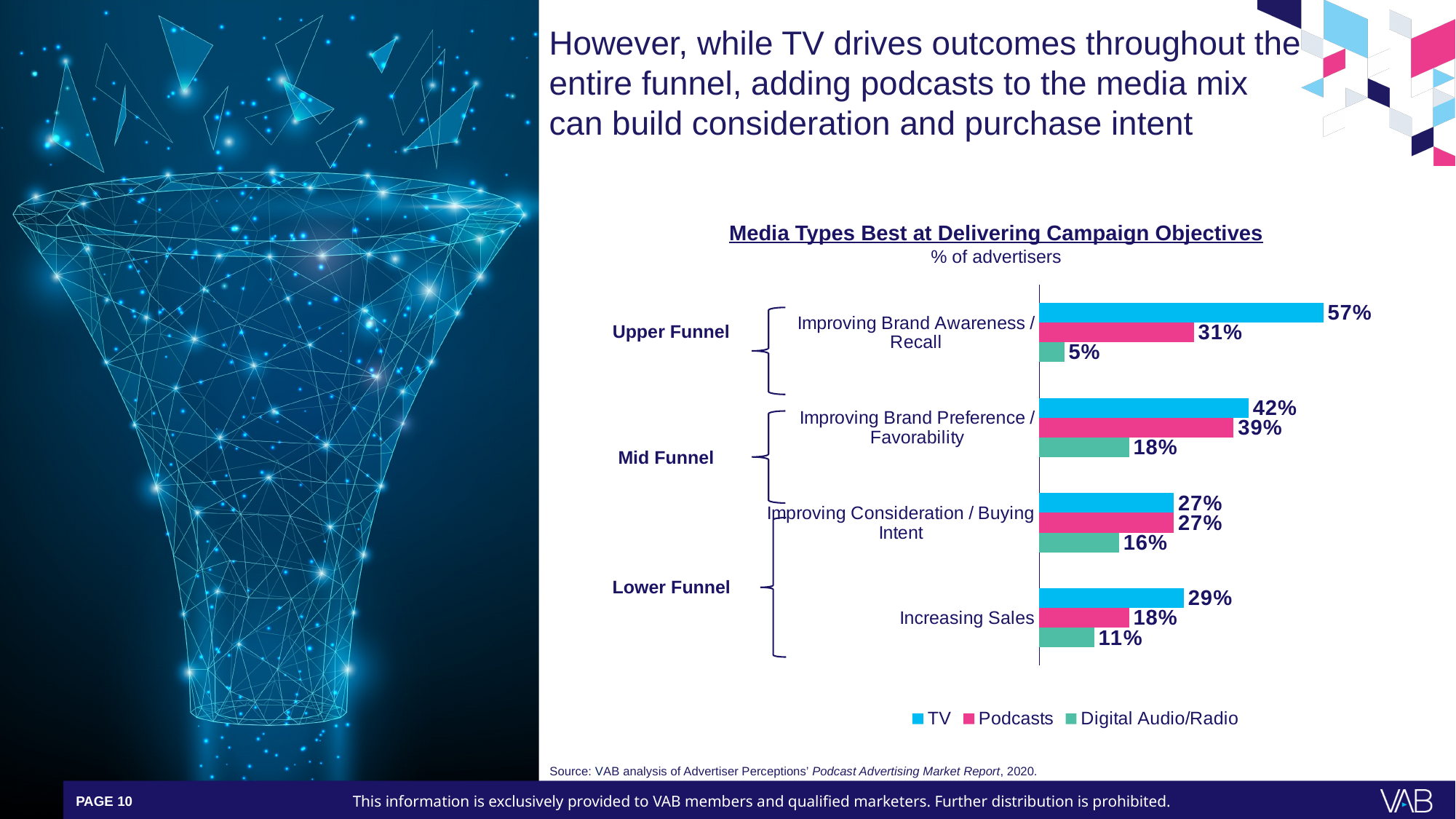
How many campaign objectives are shown in the chart? 4 What is the Podcasts value for Improving Brand Preference / Favorability? 39% What is the Digital Audio/Radio value for Increasing Sales? 11% What type of chart is shown on the slide? Bar chart Which campaign objective has the highest TV value? Improving Brand Awareness / Recall Which campaign objective has the lowest Digital Audio/Radio value? Improving Brand Awareness / Recall How many series does the legend list? 3 Which colour represents Podcasts in the chart? Pink For Increasing Sales, which is larger: the TV value or the Podcasts value? TV What is the title of the chart? Media Types Best at Delivering Campaign Objectives What is the difference between the TV and Podcasts values for Improving Brand Awareness / Recall? 26% What percentage of advertisers say TV is best at Improving Brand Awareness / Recall? 57%